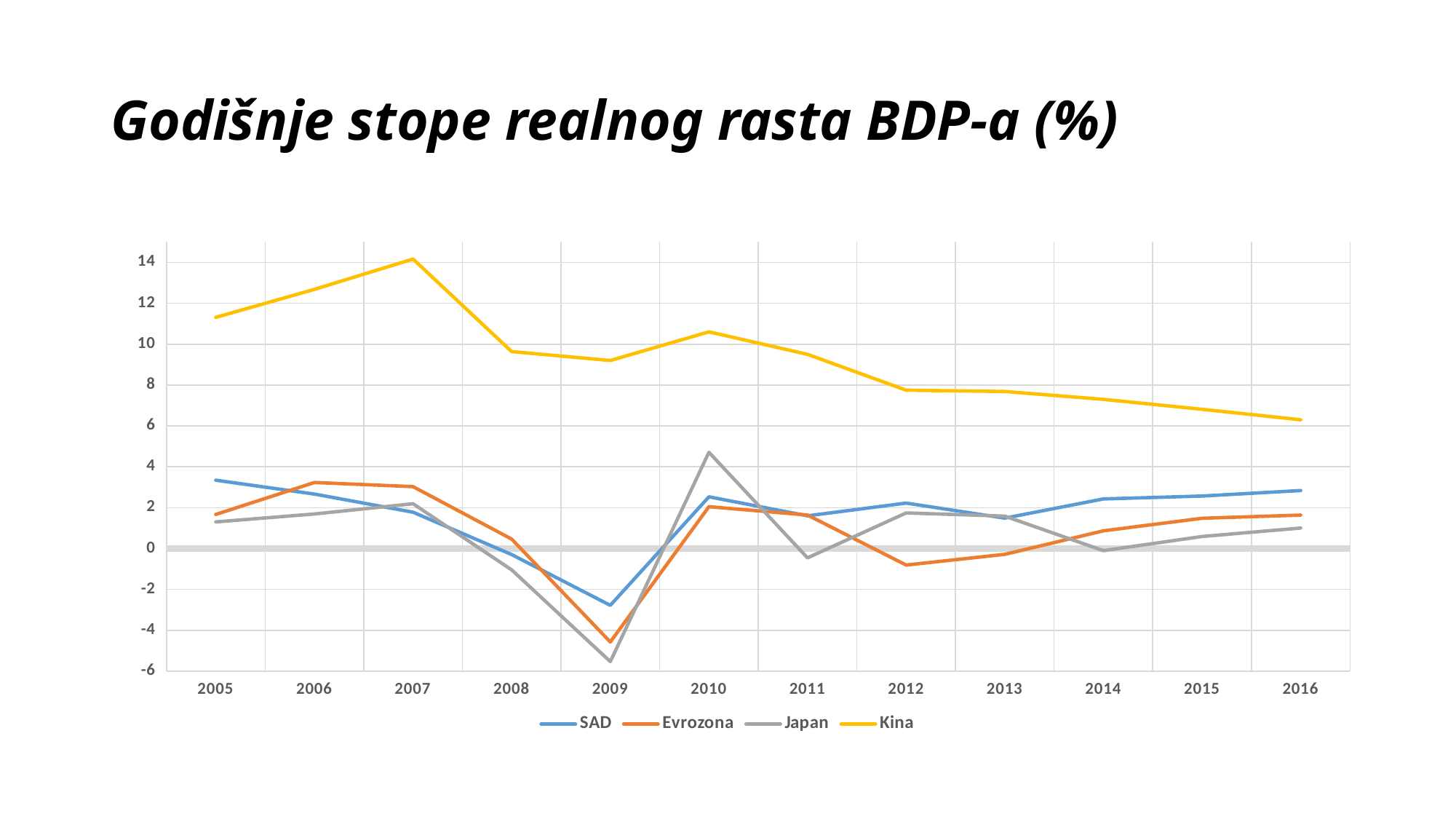
Which series has the highest value in 2007? Kina Does the Kina line rise or fall from 2010 to 2016? fall Is the value for Japan in 2009 greater or less than -4? less What kind of chart is shown on the slide? line chart In which year does the Kina line reach its highest value? 2007 In 2010, which is higher, Japan or SAD? Japan How many series does the legend list? 4 Is the value for Kina in 2016 greater or less than 8? less Is the value for SAD in 2005 greater or less than 2? greater Which series has the lowest value in 2009? Japan How many years are shown on the x axis? 12